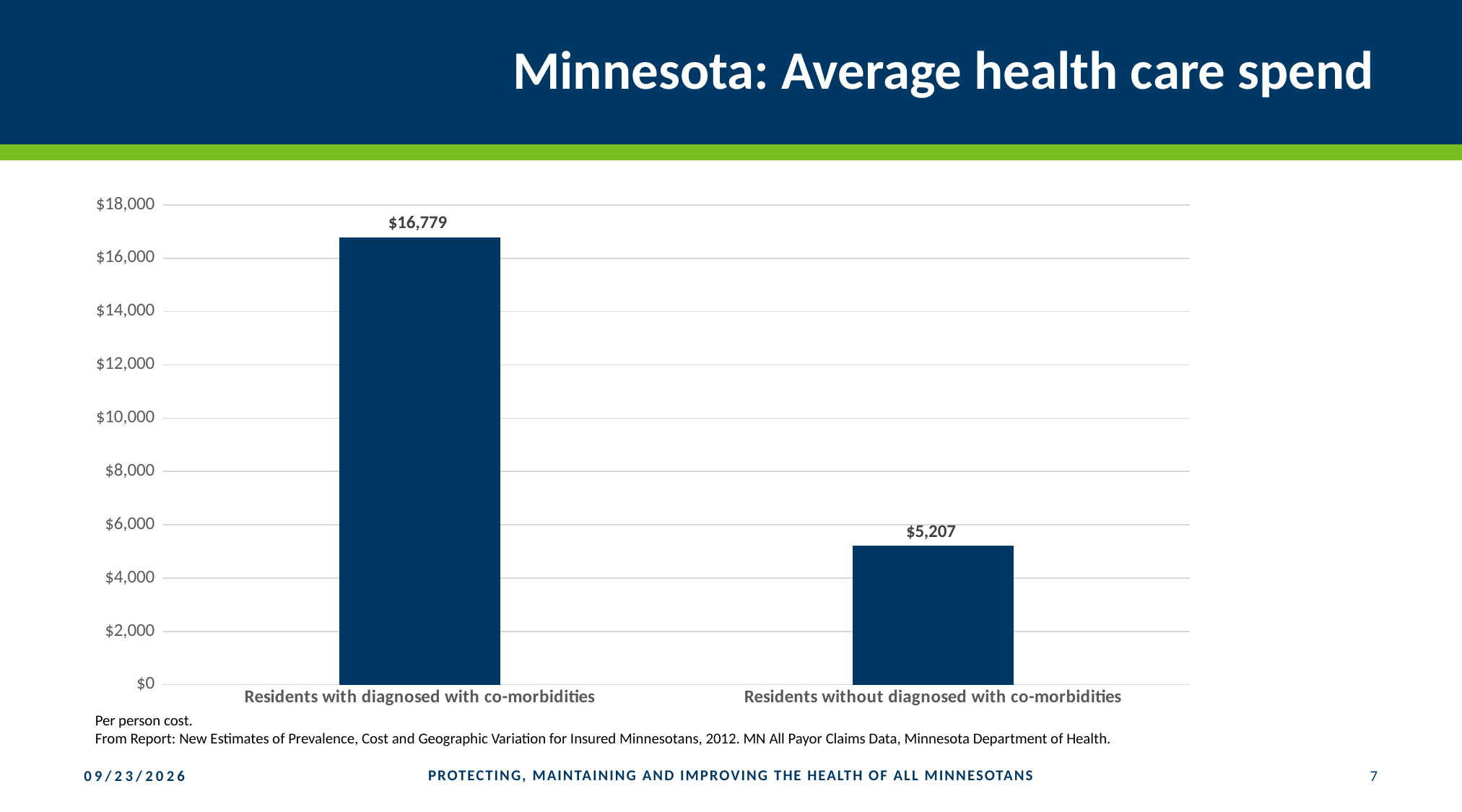
What is the average health care spend for residents without diagnosed with co-morbidities? $5,207 What is the difference in average health care spend between residents with and without diagnosed co-morbidities? $11,572 What kind of chart is shown on the slide? Bar chart What is the title of the slide? Minnesota: Average health care spend What is the highest value shown on the y axis? $18,000 What is the average health care spend for residents with diagnosed with co-morbidities? $16,779 Is the value for residents with diagnosed with co-morbidities greater or less than $16,000? greater How many categories are shown on the chart? 2 Is the value for residents without diagnosed with co-morbidities greater or less than $6,000? less Which category has the higher average health care spend? Residents with diagnosed with co-morbidities Which category has the lower average health care spend? Residents without diagnosed with co-morbidities